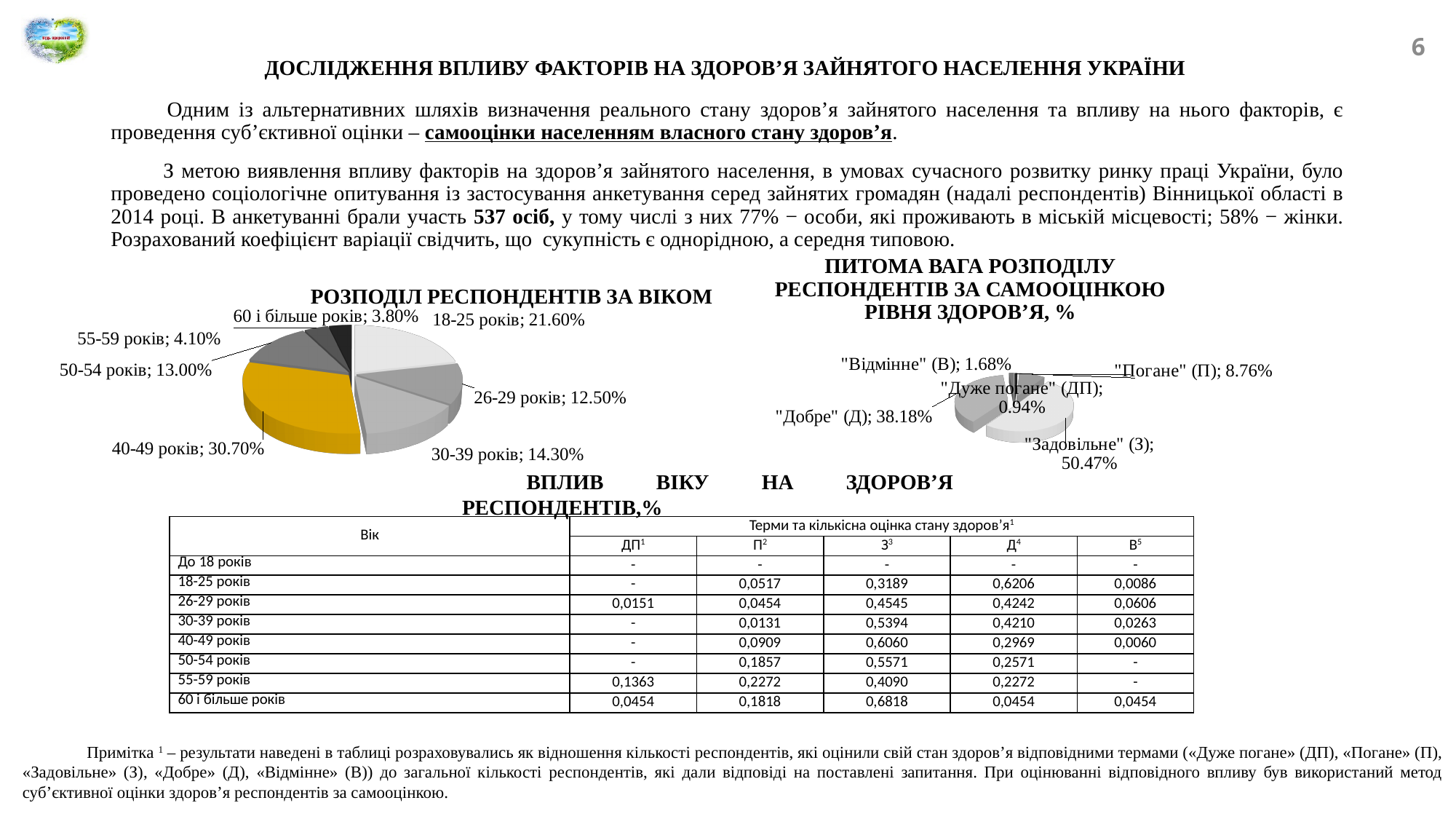
In the chart 'РОЗПОДІЛ РЕСПОНДЕНТІВ ЗА ВІКОМ', which is larger: the share for 50-54 років or for 55-59 років? 50-54 років In the chart 'РОЗПОДІЛ РЕСПОНДЕНТІВ ЗА ВІКОМ', how many age groups are shown? 7 What type of chart is 'РОЗПОДІЛ РЕСПОНДЕНТІВ ЗА ВІКОМ'? Pie chart In the chart 'ПИТОМА ВАГА РОЗПОДІЛУ РЕСПОНДЕНТІВ ЗА САМООЦІНКОЮ РІВНЯ ЗДОРОВ'Я, %', which health rating has the smallest share? "Дуже погане" (ДП) In the chart 'ПИТОМА ВАГА РОЗПОДІЛУ РЕСПОНДЕНТІВ ЗА САМООЦІНКОЮ РІВНЯ ЗДОРОВ'Я, %', what share of respondents rated their health as "Задовільне" (З)? 50.47% In the chart 'РОЗПОДІЛ РЕСПОНДЕНТІВ ЗА ВІКОМ', what is the difference in percentage points between the 30-39 років and 26-29 років slices? 1.80% In the chart 'РОЗПОДІЛ РЕСПОНДЕНТІВ ЗА ВІКОМ', which age group has the smallest share? 60 і більше років In the chart 'РОЗПОДІЛ РЕСПОНДЕНТІВ ЗА ВІКОМ', what share of respondents are aged 18-25 років? 21.60% In the chart 'РОЗПОДІЛ РЕСПОНДЕНТІВ ЗА ВІКОМ', what share of respondents are aged 40-49 років? 30.70% In the chart 'ПИТОМА ВАГА РОЗПОДІЛУ РЕСПОНДЕНТІВ ЗА САМООЦІНКОЮ РІВНЯ ЗДОРОВ'Я, %', how many health rating categories are shown? 5 In the chart 'ПИТОМА ВАГА РОЗПОДІЛУ РЕСПОНДЕНТІВ ЗА САМООЦІНКОЮ РІВНЯ ЗДОРОВ'Я, %', what is the difference in percentage points between "Погане" (П) and "Відмінне" (В)? 7.08% In the chart 'РОЗПОДІЛ РЕСПОНДЕНТІВ ЗА ВІКОМ', which age group has the largest share? 40-49 років